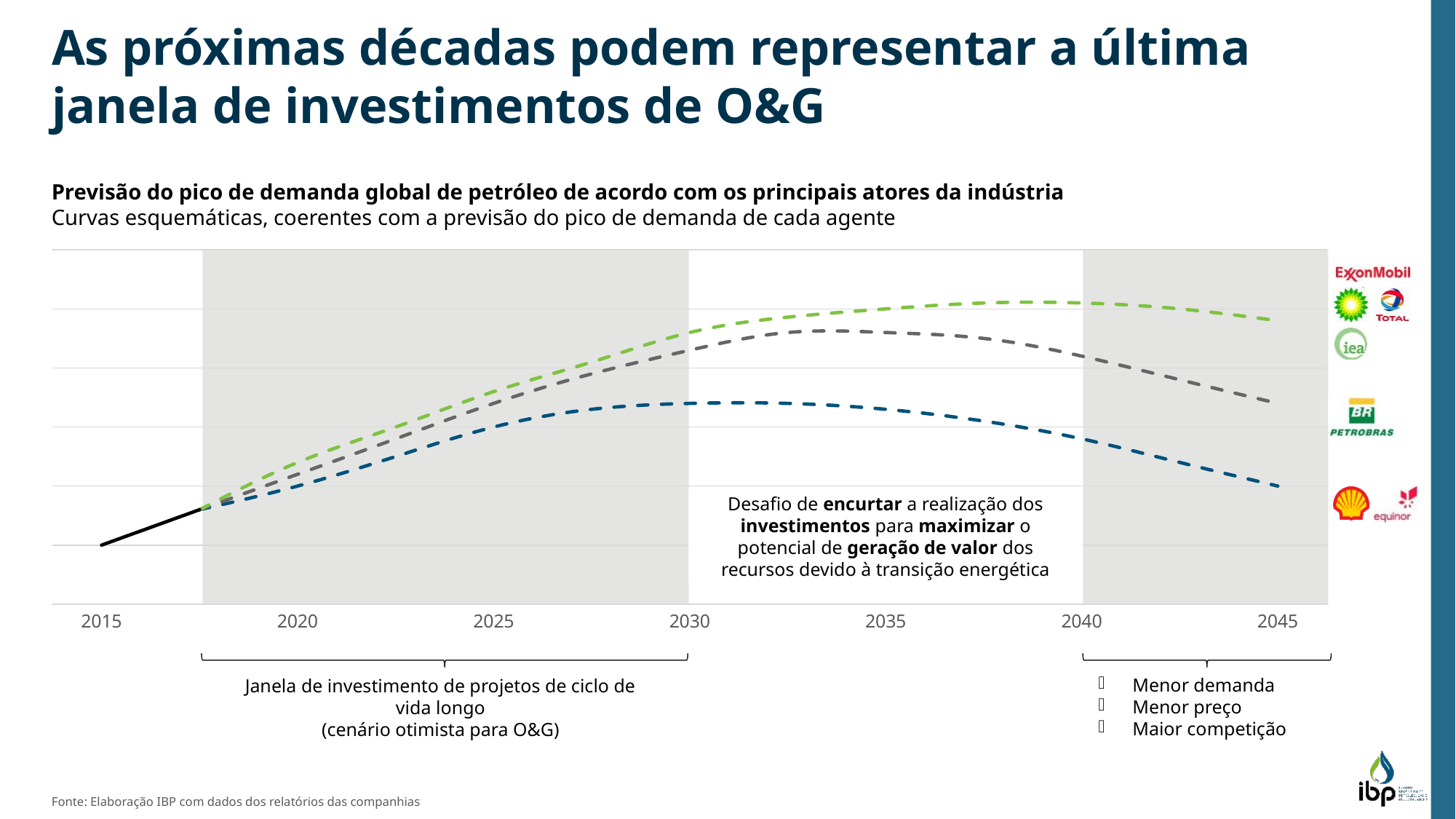
What is the last year shown on the x axis? 2045 Which dashed curve is the highest at 2045: green, grey or blue? green Does the blue dashed curve rise or fall between 2035 and 2045? fall What is the first year shown on the x axis? 2015 What label appears under the bracket spanning 2020 to 2030 below the chart? Janela de investimento de projetos de ciclo de vida longo (cenário otimista para O&G) What kind of chart is shown on the slide? line chart What is the title of the chart? Previsão do pico de demanda global de petróleo de acordo com os principais atores da indústria Which dashed curve reaches its peak latest along the x axis: green, grey or blue? green Does the green dashed curve rise or fall between 2020 and 2030? rise Which dashed curve is the lowest at 2045: green, grey or blue? blue How many year labels are shown on the x axis of the chart? 7 How many dashed curves are plotted on the chart? 3